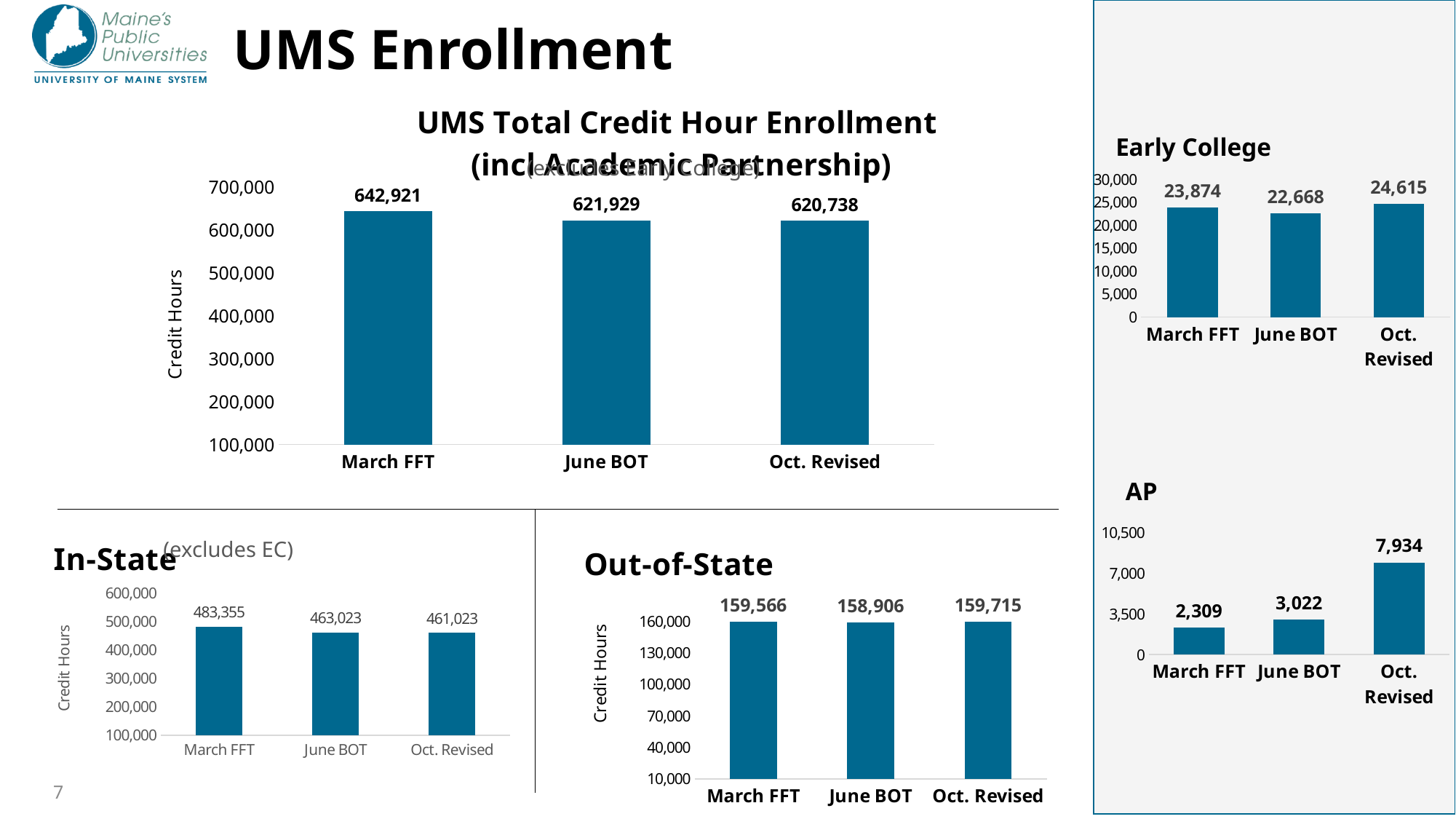
In the UMS Total Credit Hour Enrollment chart, what is the value for March FFT? 642,921 In the In-State chart, which category has the highest value? March FFT In the AP chart, do the values rise or fall from March FFT to Oct. Revised? rise In the Out-of-State chart, what is the value for June BOT? 158,906 In the AP chart, which category has the highest value? Oct. Revised In the Early College chart, what is the difference between the Oct. Revised and June BOT values? 1,947 In the UMS Total Credit Hour Enrollment chart, what is the difference between the March FFT and June BOT values? 20,992 In the AP chart, what is the value for Oct. Revised? 7,934 In the Early College chart, what is the value for June BOT? 22,668 What kind of chart is the Out-of-State chart? bar chart In the In-State chart, what is the value for Oct. Revised? 461,023 In the AP chart, is the value for March FFT greater or less than 3,500? less